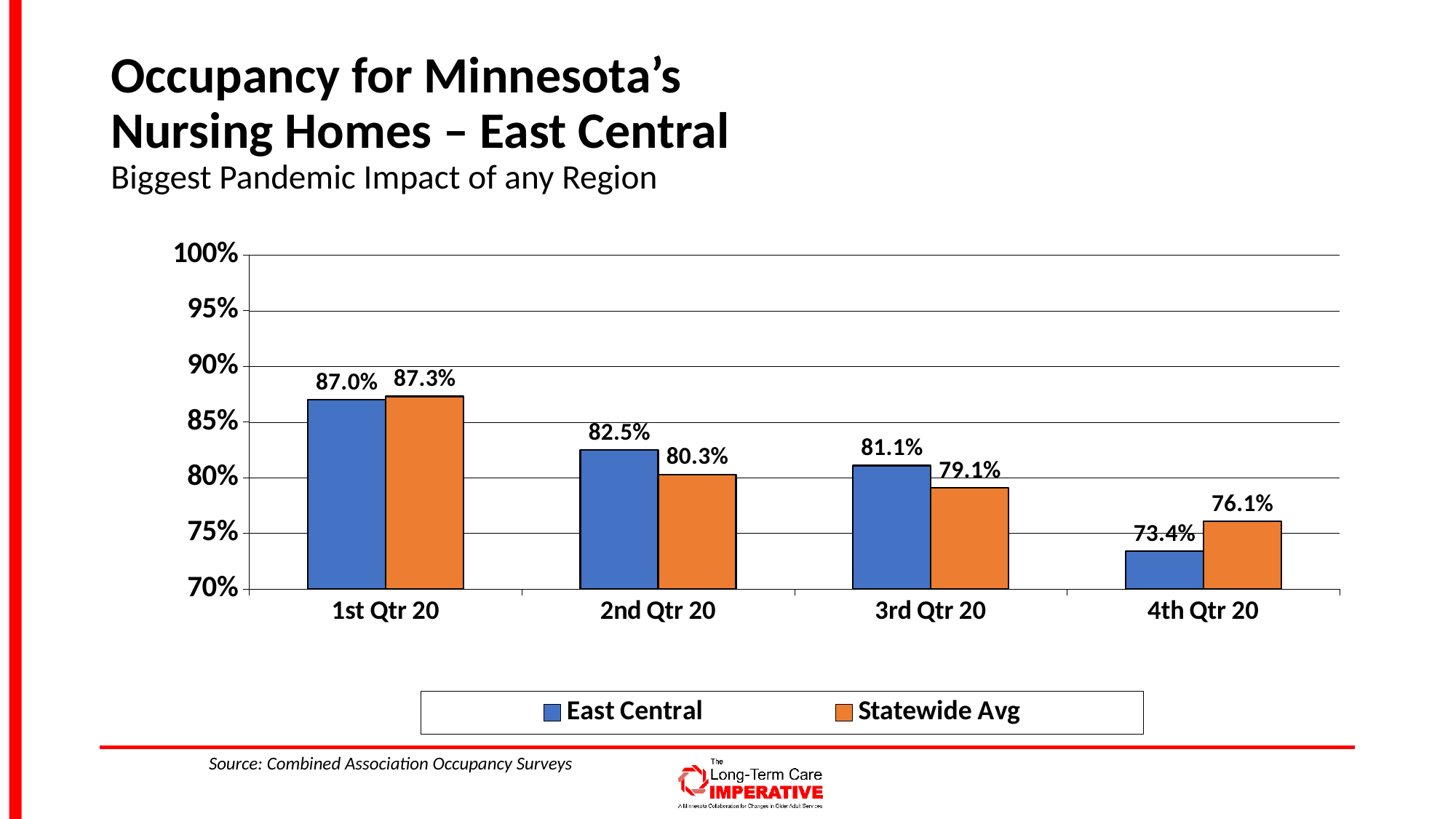
What is the difference between the East Central and Statewide Avg values in 4th Qtr 20? 2.7% What kind of chart is shown on the slide? Bar chart Which is larger in 3rd Qtr 20, East Central or Statewide Avg? East Central In which quarter is the East Central occupancy lowest? 4th Qtr 20 What is the difference between the East Central values for 1st Qtr 20 and 4th Qtr 20? 13.6% In which quarter is the Statewide Avg occupancy highest? 1st Qtr 20 How many series does the legend list? 2 What is the Statewide Avg occupancy value for 4th Qtr 20? 76.1% How many quarters are shown on the x axis? 4 What is the East Central occupancy value for 1st Qtr 20? 87.0% Do the East Central values rise or fall from 1st Qtr 20 to 4th Qtr 20? Fall What is the East Central occupancy value for 2nd Qtr 20? 82.5%